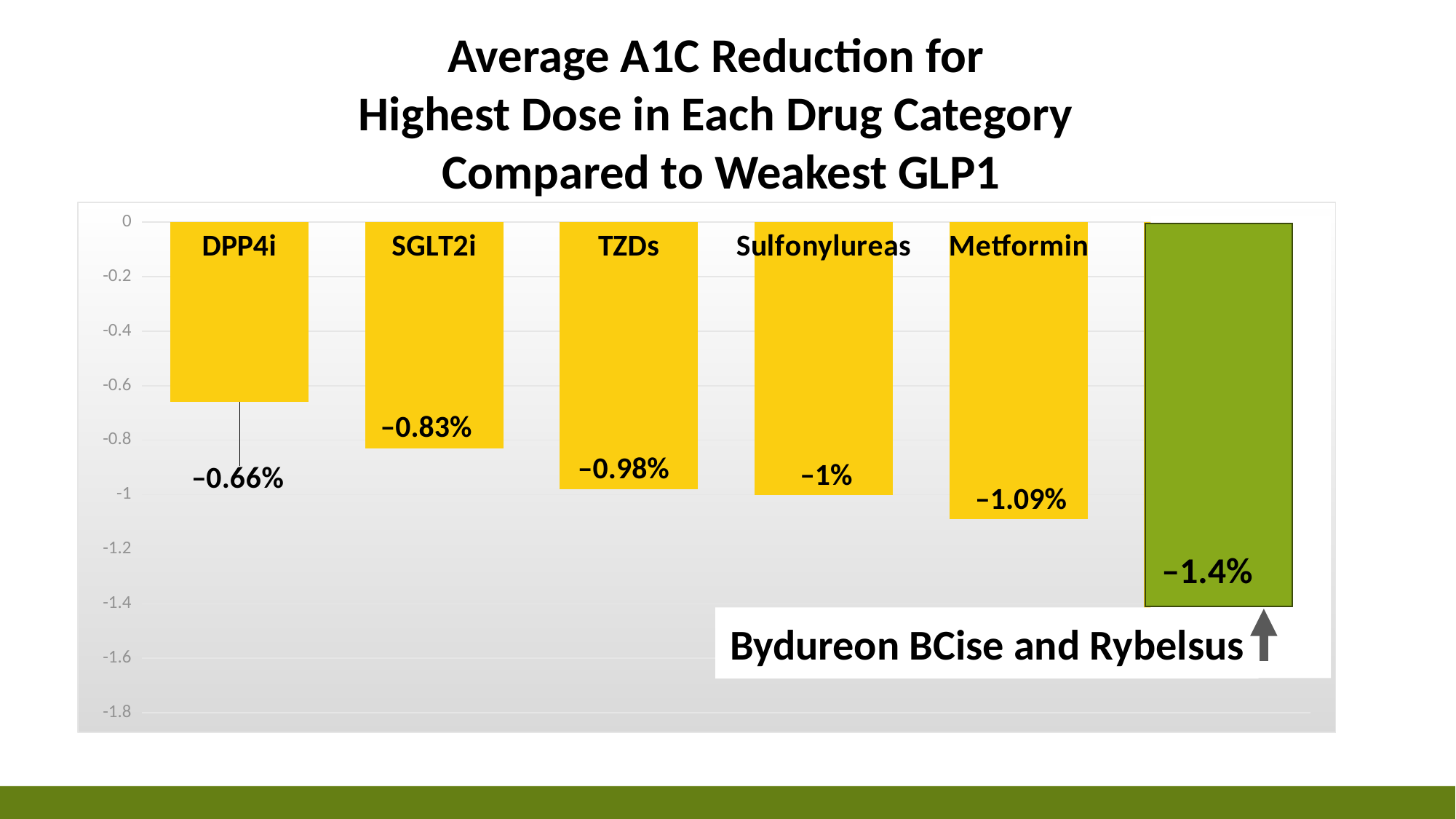
What is the average A1C reduction shown for DPP4i? –0.66% What is the average A1C reduction shown for Metformin? –1.09% What is the value labelled on the Sulfonylureas bar? –1% Which category shows the smallest A1C reduction (the value closest to zero)? DPP4i Which category shows the largest A1C reduction (the most negative value)? Bydureon BCise and Rybelsus Which bar is coloured green rather than yellow? Bydureon BCise and Rybelsus What is the average A1C reduction shown for Bydureon BCise and Rybelsus? –1.4% What type of chart is shown on the slide? Bar chart By how many percentage points does the A1C reduction for Bydureon BCise and Rybelsus exceed that for DPP4i? 0.74 How many bars are plotted in the chart? 6 Which shows a larger A1C reduction, TZDs or SGLT2i? TZDs What is the average A1C reduction shown for SGLT2i? –0.83%